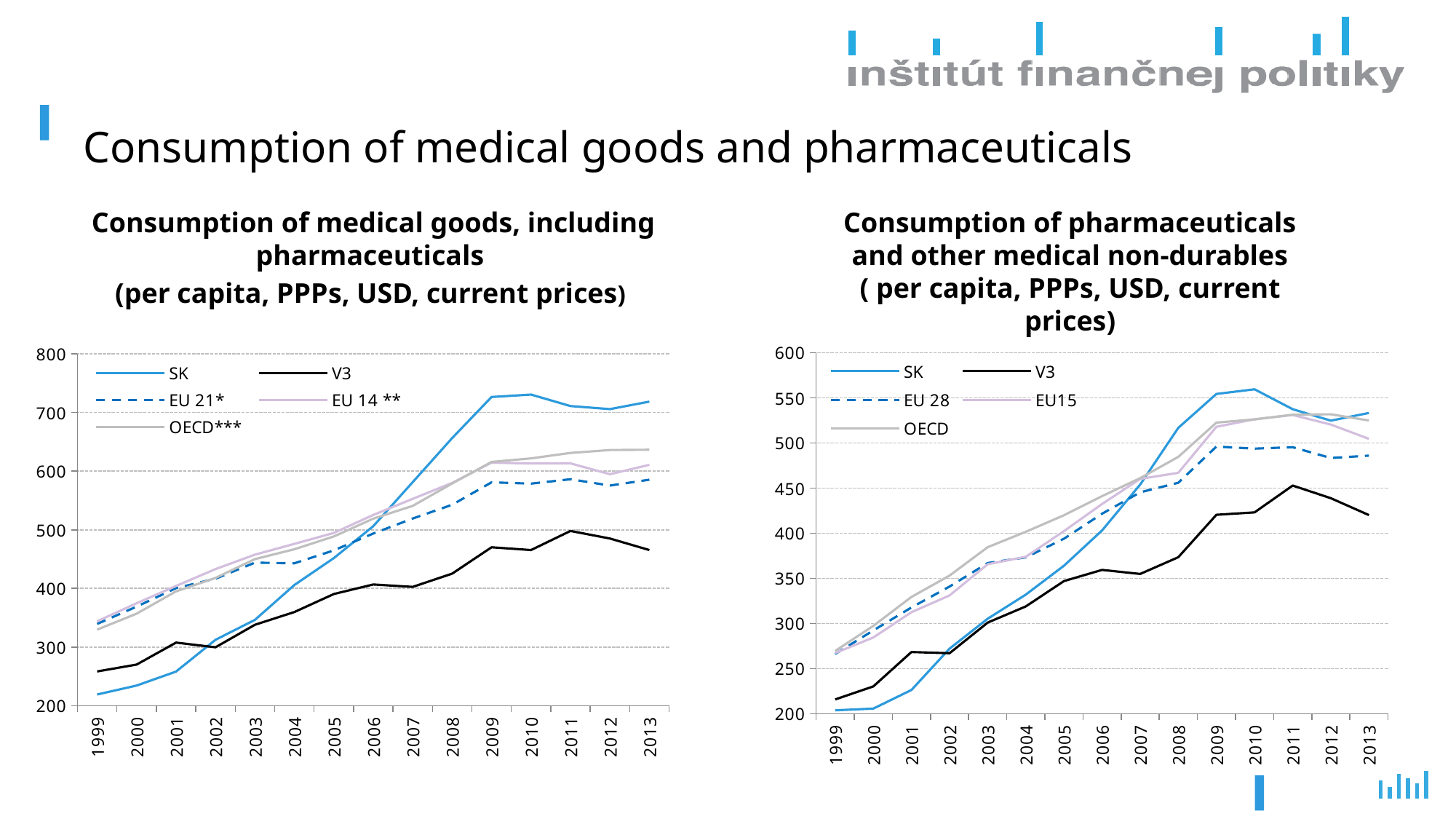
In the right chart, is the value for V3 in 2013 greater or less than 450? less How many series does the legend of the right chart, 'Consumption of pharmaceuticals and other medical non-durables', list? 5 In the left chart, which series has the highest value in 2013? SK In the left chart, does the SK series generally rise or fall from 1999 to 2013? rise What type of chart is the left chart, 'Consumption of medical goods, including pharmaceuticals'? line chart In the right chart, is the value for SK in 1999 greater or less than 250? less In the left chart, is the value for SK in 1999 greater or less than 300? less How many series does the legend of the left chart list? 5 In the left chart, which series has the lowest value in 2013? V3 In the right chart, which is larger in 2013, SK or V3? SK How many years are shown on the x axis of the left chart? 15